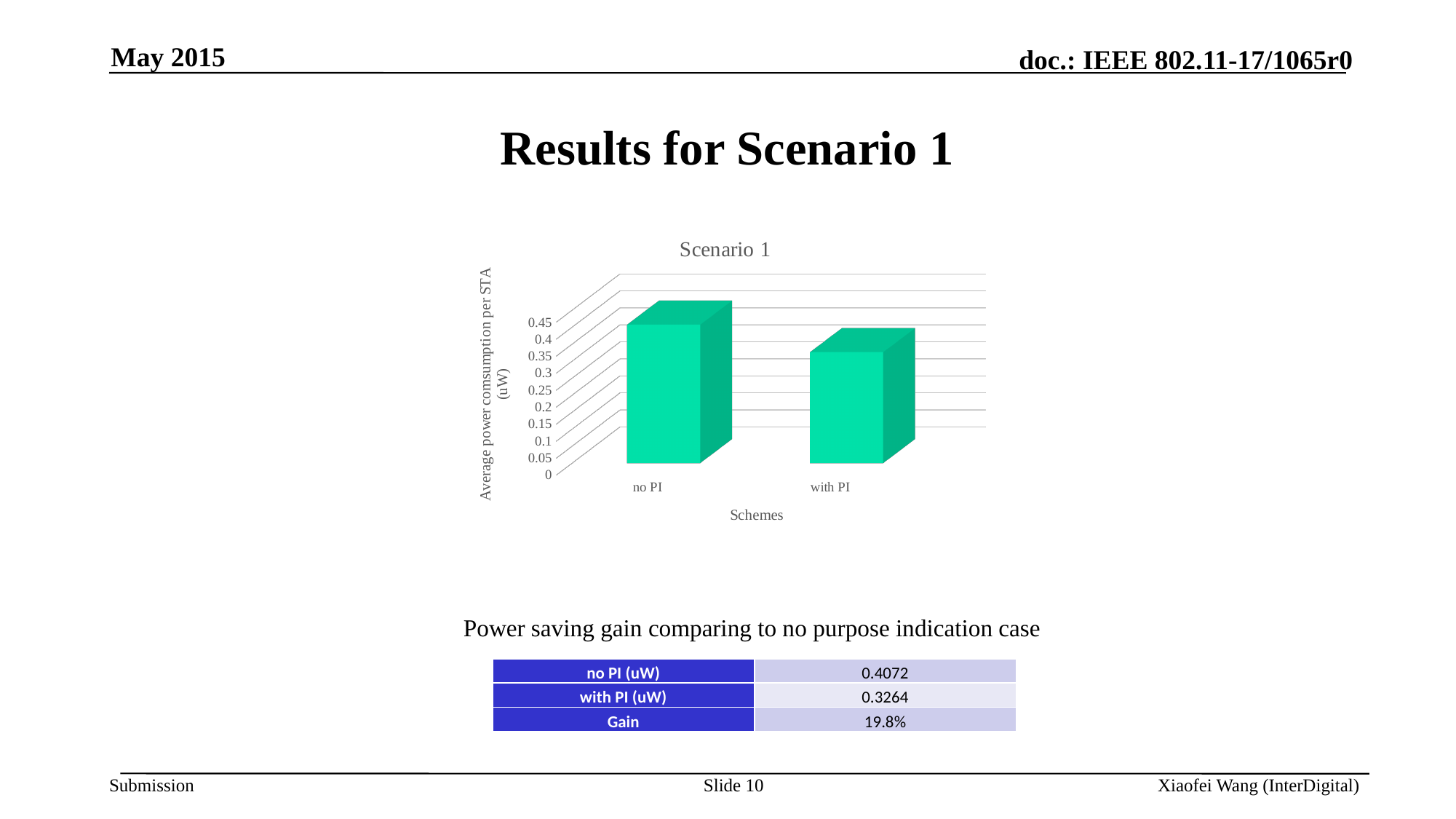
Which bar is taller, no PI or with PI? no PI What kind of chart is shown on the slide? bar chart Is the value for with PI greater or less than 0.4? less Using the values printed on the slide, what is the difference between the no PI and with PI power consumption (uW)? 0.0808 What is the title of the chart? Scenario 1 Which scheme has the lowest average power consumption per STA? with PI According to the slide, what is the average power consumption per STA for no PI (uW)? 0.4072 Is the value for no PI greater or less than 0.3? greater How many schemes (categories) are plotted in the chart? 2 Which scheme has the highest average power consumption per STA? no PI Do the values rise or fall going from no PI to with PI along the x axis? fall According to the slide, what is the average power consumption per STA for with PI (uW)? 0.3264